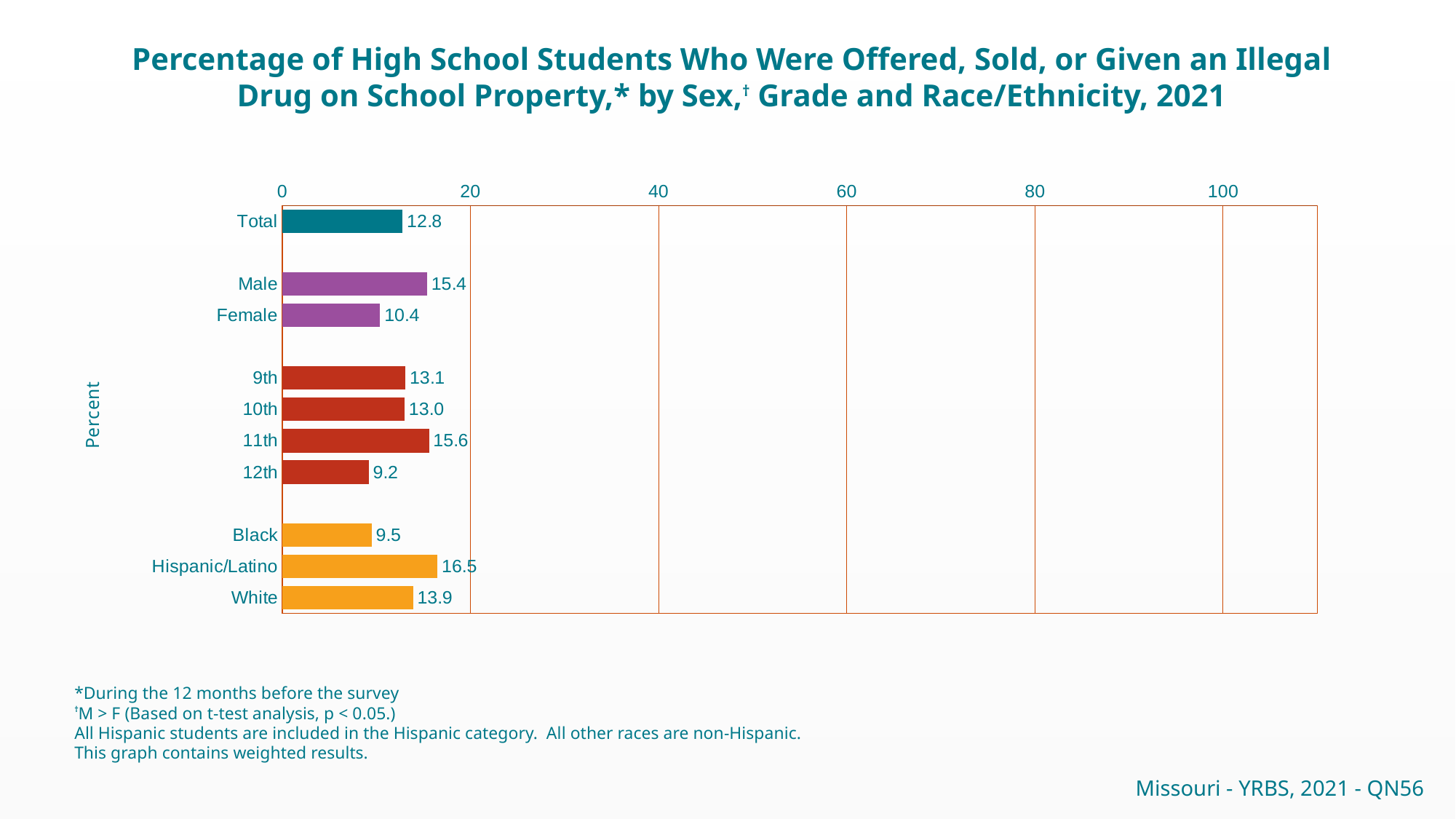
What is the value for Total? 12.8 What is the difference between the Male and Female values? 5.0 What is the value for Hispanic/Latino? 16.5 How many categories are plotted in the chart? 11 Which is larger, the value for Black or the value for White? White Which category has the highest value? Hispanic/Latino Which category has the lowest value? 12th What is the difference between the Hispanic/Latino and Black values? 7.0 What is the value for 12th grade? 9.2 What is the label on the vertical axis? Percent Is the value for 11th grade greater or less than 20? less What kind of chart is shown on the slide? Bar chart